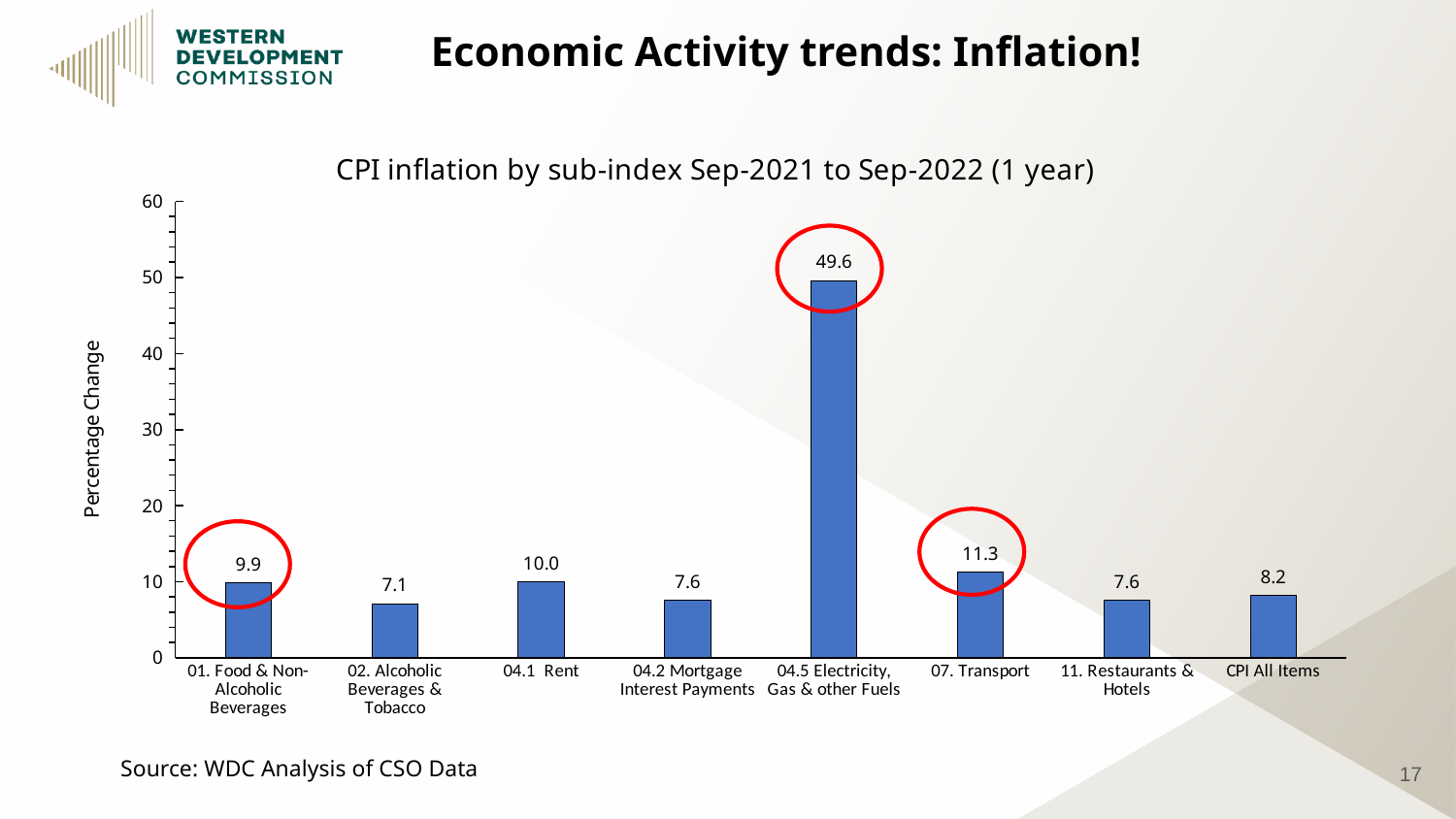
What is the value for 04.5 Electricity, Gas & other Fuels? 49.6 What is the value for CPI All Items? 8.2 How many categories are shown on the x axis? 8 What is the value for 07. Transport? 11.3 What is the title of the chart? CPI inflation by sub-index Sep-2021 to Sep-2022 (1 year) What kind of chart is this? bar chart Which category has the highest value? 04.5 Electricity, Gas & other Fuels Is the value for 04.5 Electricity, Gas & other Fuels greater or less than 40? greater What is the difference between the values for 04.5 Electricity, Gas & other Fuels and 07. Transport? 38.3 What is the value for 04.1 Rent? 10.0 Which is larger, the value for 01. Food & Non-Alcoholic Beverages or the value for CPI All Items? 01. Food & Non-Alcoholic Beverages Which category has the lowest value? 02. Alcoholic Beverages & Tobacco